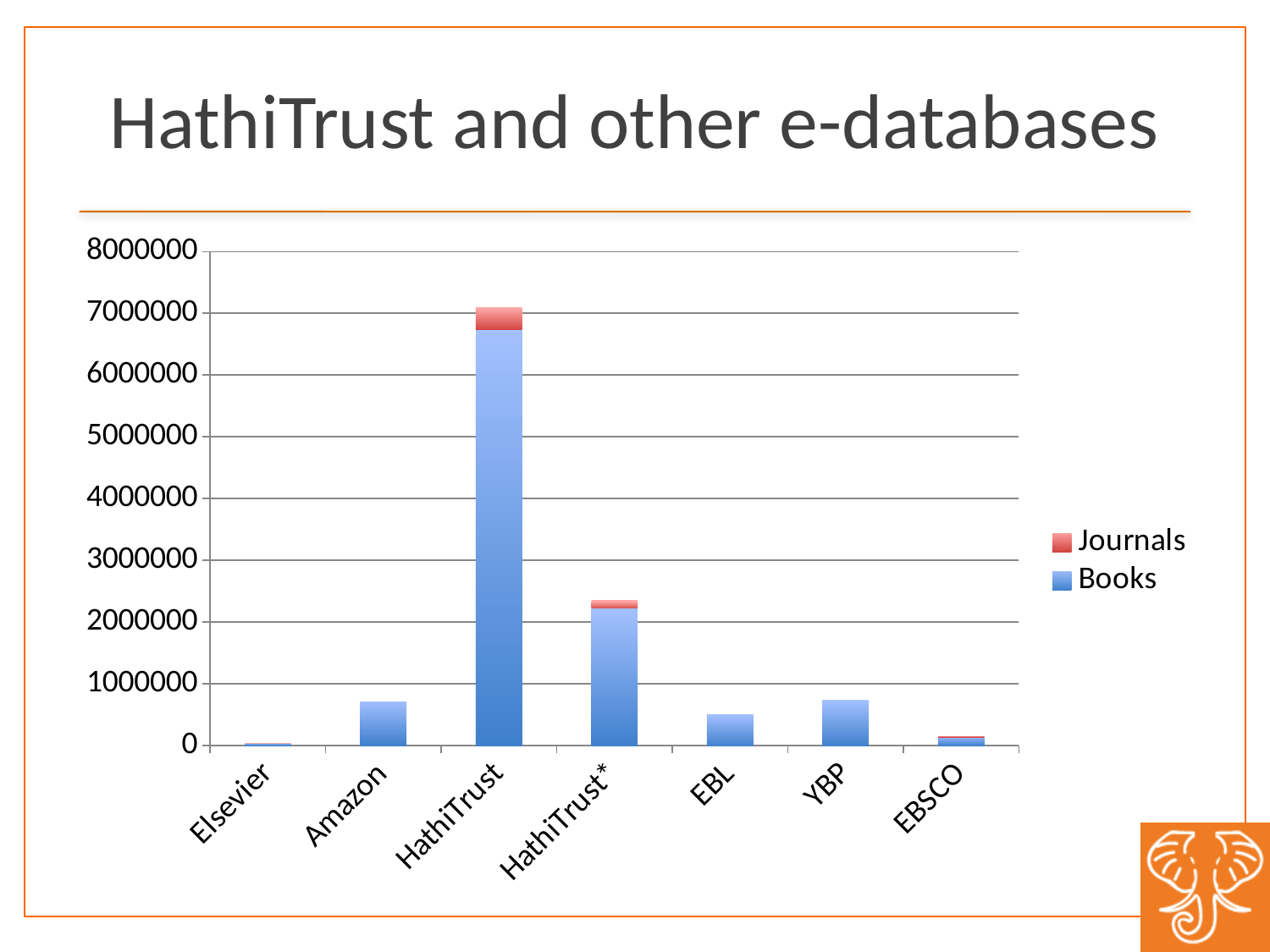
Is the value for Amazon greater or less than 1000000? less Which bar is taller, Amazon or EBL? Amazon How many series does the chart's legend list? 2 What is the title of the slide containing the chart? HathiTrust and other e-databases Which category has the tallest bar in the chart? HathiTrust What kind of chart is shown on the slide? Stacked bar chart Which series is shown in red in the chart? Journals Which bar is taller, HathiTrust or HathiTrust*? HathiTrust Is the total value for HathiTrust* greater or less than 2000000? greater How many categories are shown on the x axis of the chart? 7 Is the total value for HathiTrust greater or less than 6000000? greater Which category has the shortest bar in the chart? Elsevier